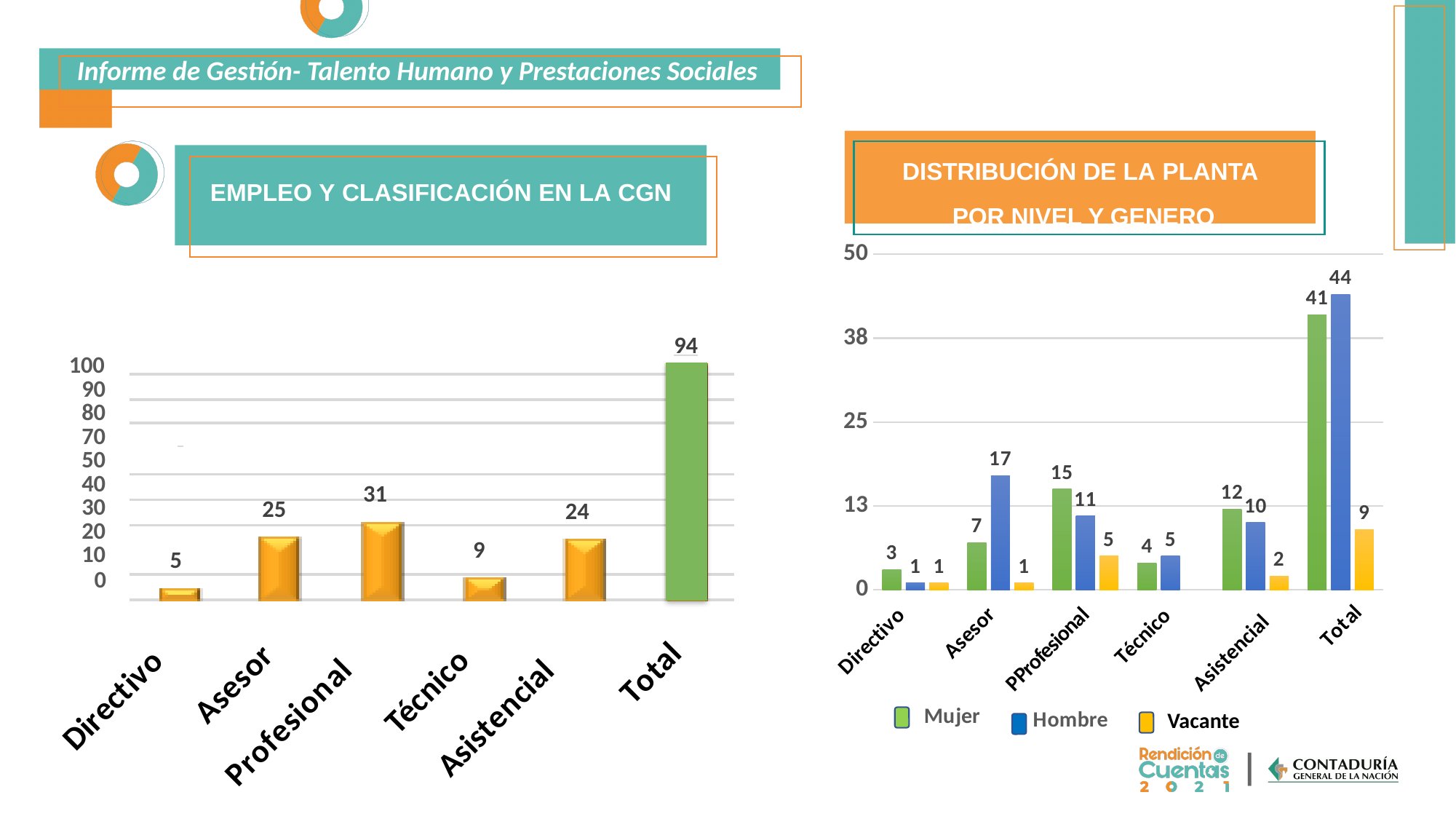
In the chart 'EMPLEO Y CLASIFICACIÓN EN LA CGN', what is the value for Total? 94 In the chart 'EMPLEO Y CLASIFICACIÓN EN LA CGN', which category other than Total has the lowest value? Directivo In the chart 'EMPLEO Y CLASIFICACIÓN EN LA CGN', what is the difference between Asesor and Técnico? 16 In the chart 'EMPLEO Y CLASIFICACIÓN EN LA CGN', which is larger, Asesor or Asistencial? Asesor In the chart 'DISTRIBUCIÓN DE LA PLANTA POR NIVEL Y GENERO', what is the Hombre value for Asesor? 17 In the chart 'EMPLEO Y CLASIFICACIÓN EN LA CGN', what is the value for Profesional? 31 In the chart 'DISTRIBUCIÓN DE LA PLANTA POR NIVEL Y GENERO', what is the Vacante value for Total? 9 In the chart 'DISTRIBUCIÓN DE LA PLANTA POR NIVEL Y GENERO', which is larger for Profesional, Mujer or Hombre? Mujer In the chart 'DISTRIBUCIÓN DE LA PLANTA POR NIVEL Y GENERO', what is the difference between the Mujer and Hombre values for Total? 3 What kind of chart is 'DISTRIBUCIÓN DE LA PLANTA POR NIVEL Y GENERO'? Bar chart In the chart 'DISTRIBUCIÓN DE LA PLANTA POR NIVEL Y GENERO', which colour represents the Vacante series? Yellow In the chart 'DISTRIBUCIÓN DE LA PLANTA POR NIVEL Y GENERO', how many series does the legend list? 3